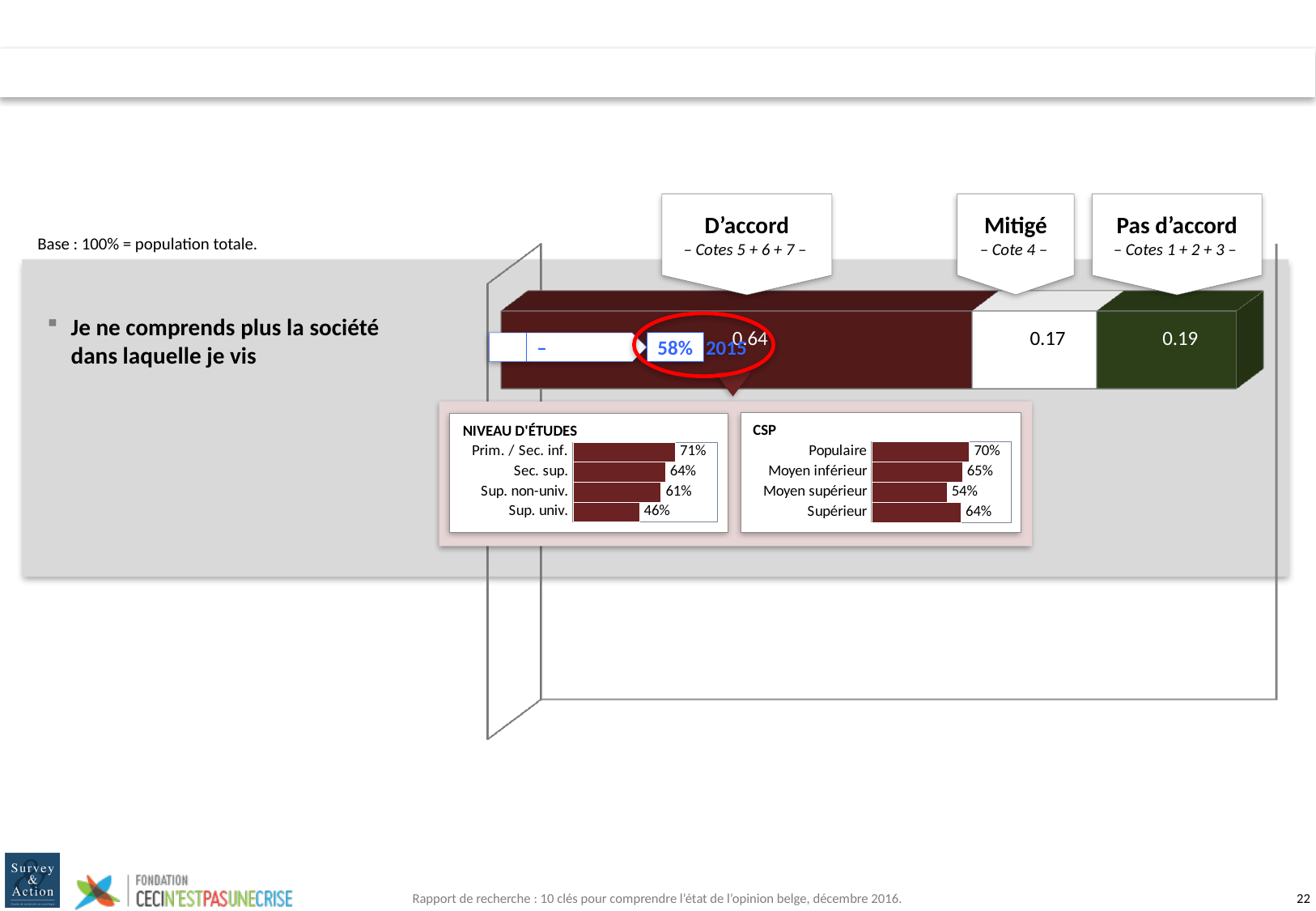
In the "NIVEAU D'ÉTUDES" chart, what is the value for "Sup. univ."? 46% In the "CSP" chart, which category has the lowest value? Moyen supérieur In the main stacked bar, what is the difference between "D'accord" and "Pas d'accord"? 0.45 In the main stacked bar for "Je ne comprends plus la société dans laquelle je vis", what is the value for "D'accord"? 0.64 In the main stacked bar, which segment is the largest? D'accord In the main stacked bar, what is the value for "Pas d'accord"? 0.19 In the "CSP" chart, what is the value for "Moyen supérieur"? 54% In the main stacked bar, what is the value for "Mitigé"? 0.17 In the "NIVEAU D'ÉTUDES" chart, how many categories are shown? 4 In the "CSP" chart, what is the difference between "Populaire" and "Supérieur"? 6% In the "NIVEAU D'ÉTUDES" chart, which category has the highest value? Prim. / Sec. inf. What kind of chart is the "CSP" chart? Bar chart